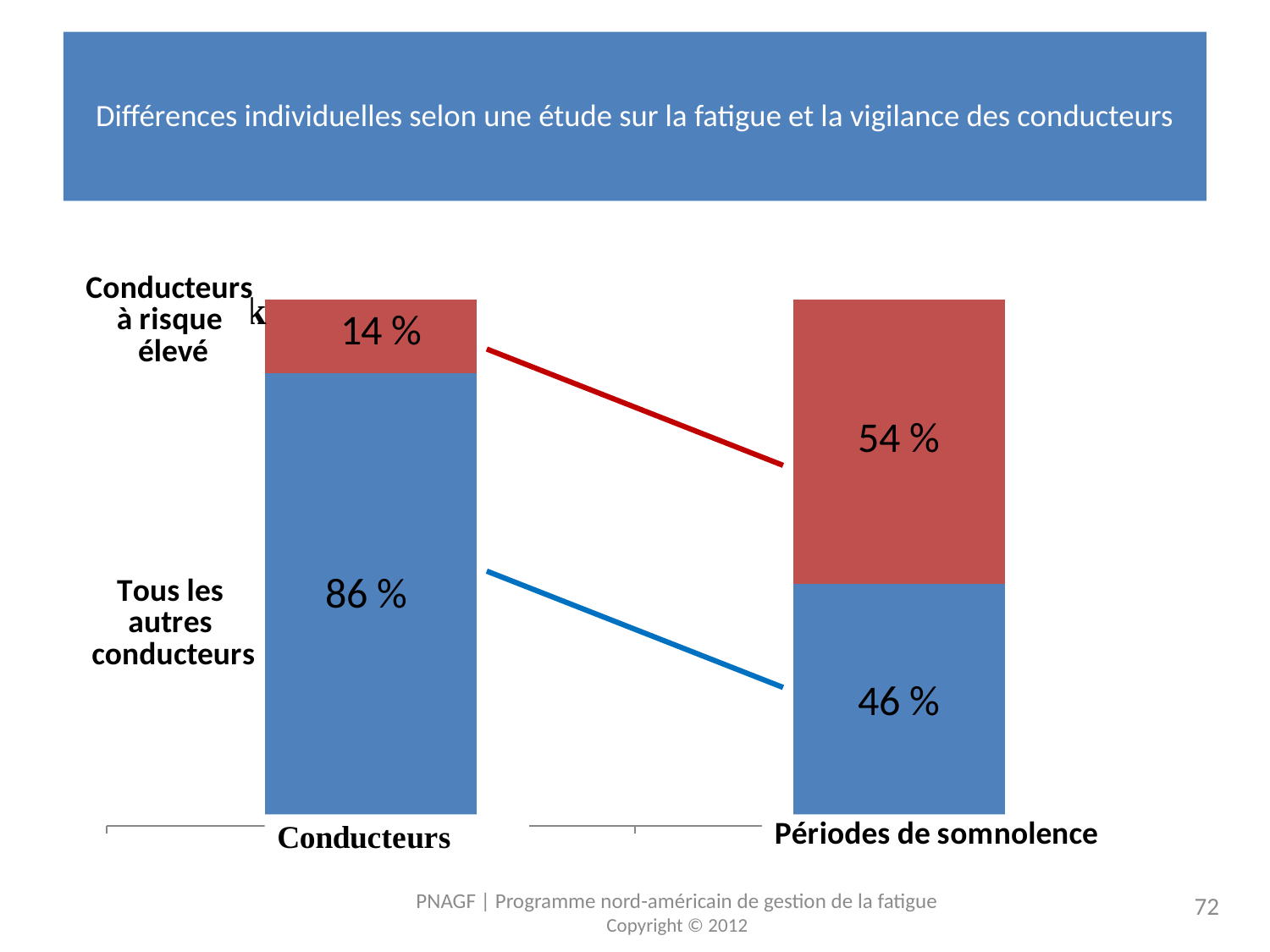
What is the difference between the two segments of the Conducteurs bar? 72 % Which is larger in the Conducteurs bar: the Conducteurs à risque élevé segment or the Tous les autres conducteurs segment? Tous les autres conducteurs How many bars are shown in the chart? 2 Which colour represents Conducteurs à risque élevé in the chart? Red What type of chart is shown on the slide? Stacked bar chart What is the total of the Périodes de somnolence stacked bar? 100 % What share of Périodes de somnolence is attributed to Conducteurs à risque élevé? 54 % What share of Périodes de somnolence is attributed to Tous les autres conducteurs? 46 % Which is larger in the Périodes de somnolence bar: the Conducteurs à risque élevé segment or the Tous les autres conducteurs segment? Conducteurs à risque élevé What is the difference between the Conducteurs à risque élevé share of Périodes de somnolence and their share of Conducteurs? 40 % What share of Conducteurs is labelled as Conducteurs à risque élevé? 14 % What share of Conducteurs is labelled as Tous les autres conducteurs? 86 %